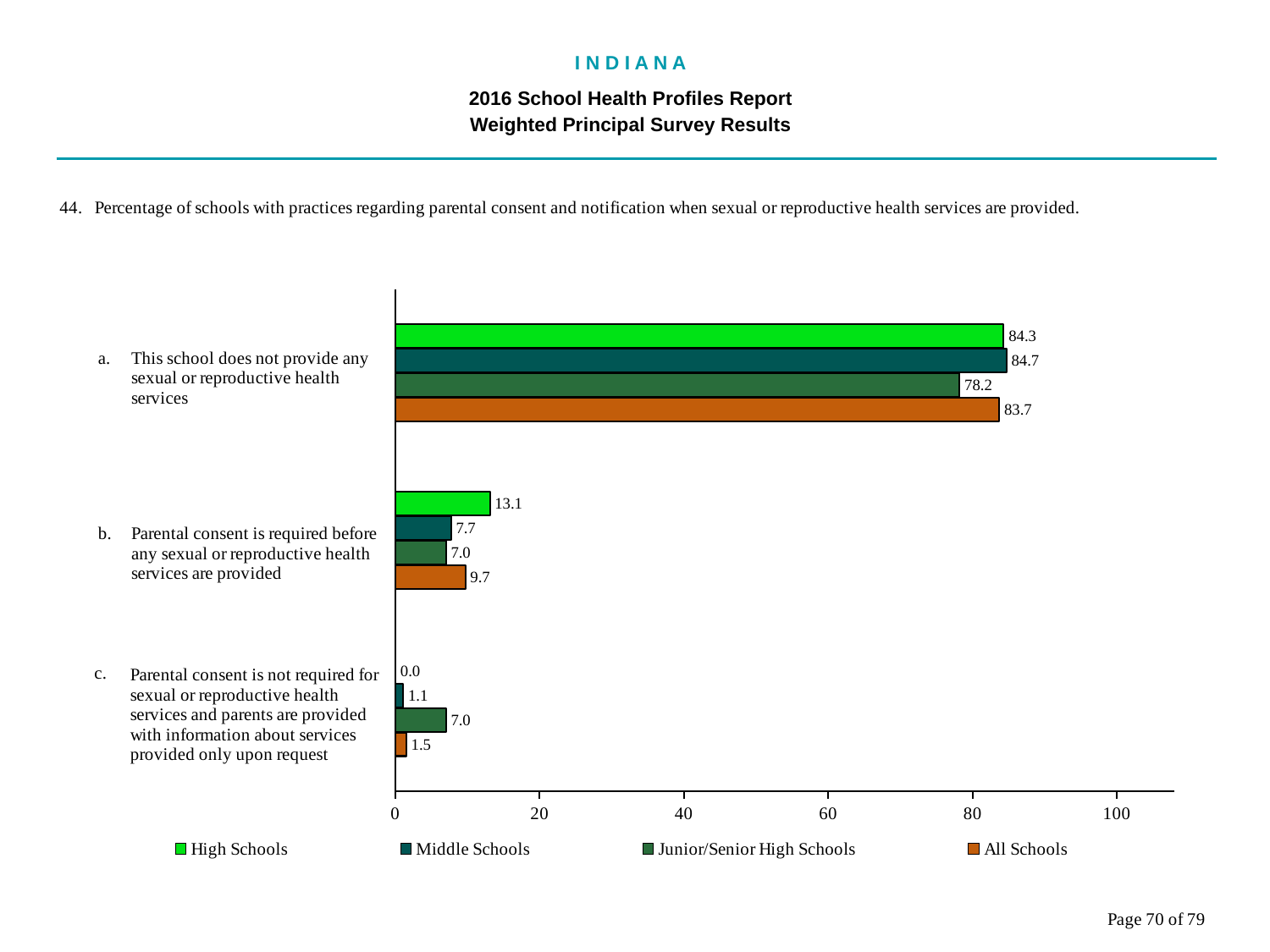
Which school type has the lowest value for item b, 'Parental consent is required before any sexual or reproductive health services are provided'? Junior/Senior High Schools What is the value for High Schools for item a, 'This school does not provide any sexual or reproductive health services'? 84.3 What is the value for Junior/Senior High Schools for item c, 'Parental consent is not required for sexual or reproductive health services and parents are provided with information about services provided only upon request'? 7.0 How many items (categories) are shown on the chart? 3 What kind of chart is shown on the slide? Bar chart Which school type has the highest value for item a, 'This school does not provide any sexual or reproductive health services'? Middle Schools What is the difference between the High Schools and Middle Schools values for item b, 'Parental consent is required before any sexual or reproductive health services are provided'? 5.4 How many series does the legend list? 4 What is the value for High Schools for item c, 'Parental consent is not required for sexual or reproductive health services and parents are provided with information about services provided only upon request'? 0.0 What is the value for All Schools for item b, 'Parental consent is required before any sexual or reproductive health services are provided'? 9.7 For item a, 'This school does not provide any sexual or reproductive health services', which is larger: the value for Junior/Senior High Schools or the value for All Schools? All Schools Is the value for Middle Schools for item a, 'This school does not provide any sexual or reproductive health services', greater or less than 80? greater